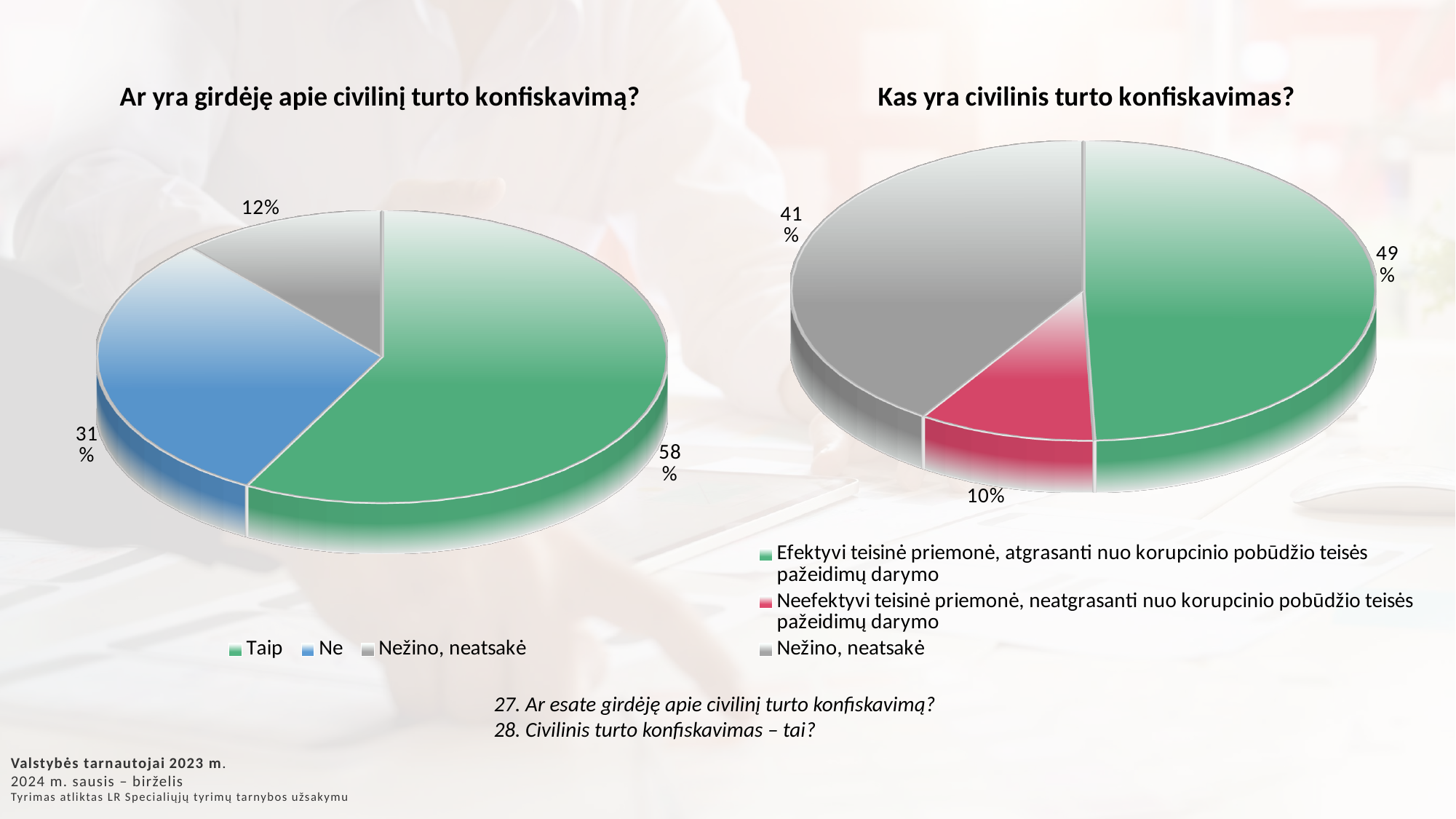
In the chart titled "Ar yra girdėję apie civilinį turto konfiskavimą?", what is the difference in percentage points between "Taip" and "Ne"? 27 In the chart titled "Ar yra girdėję apie civilinį turto konfiskavimą?", what share of respondents answered "Ne"? 31% In the chart titled "Kas yra civilinis turto konfiskavimas?", what share of respondents chose "Neefektyvi teisinė priemonė, neatgrasanti nuo korupcinio pobūdžio teisės pažeidimų darymo"? 10% In the chart titled "Ar yra girdėję apie civilinį turto konfiskavimą?", which answer has the smallest slice? Nežino, neatsakė In the chart titled "Ar yra girdėję apie civilinį turto konfiskavimą?", which answer has the largest slice? Taip In the chart titled "Kas yra civilinis turto konfiskavimas?", what share of respondents chose "Efektyvi teisinė priemonė, atgrasanti nuo korupcinio pobūdžio teisės pažeidimų darymo"? 49% What type of chart is used for "Ar yra girdėję apie civilinį turto konfiskavimą?"? Pie chart In the chart titled "Ar yra girdėję apie civilinį turto konfiskavimą?", what share is "Nežino, neatsakė"? 12% In the chart titled "Kas yra civilinis turto konfiskavimas?", what share is "Nežino, neatsakė"? 41% How many slices does the chart titled "Kas yra civilinis turto konfiskavimas?" have? 3 In the chart titled "Kas yra civilinis turto konfiskavimas?", which is larger: the "Nežino, neatsakė" slice or the "Neefektyvi teisinė priemonė" slice? Nežino, neatsakė In the chart titled "Ar yra girdėję apie civilinį turto konfiskavimą?", what share of respondents answered "Taip"? 58%